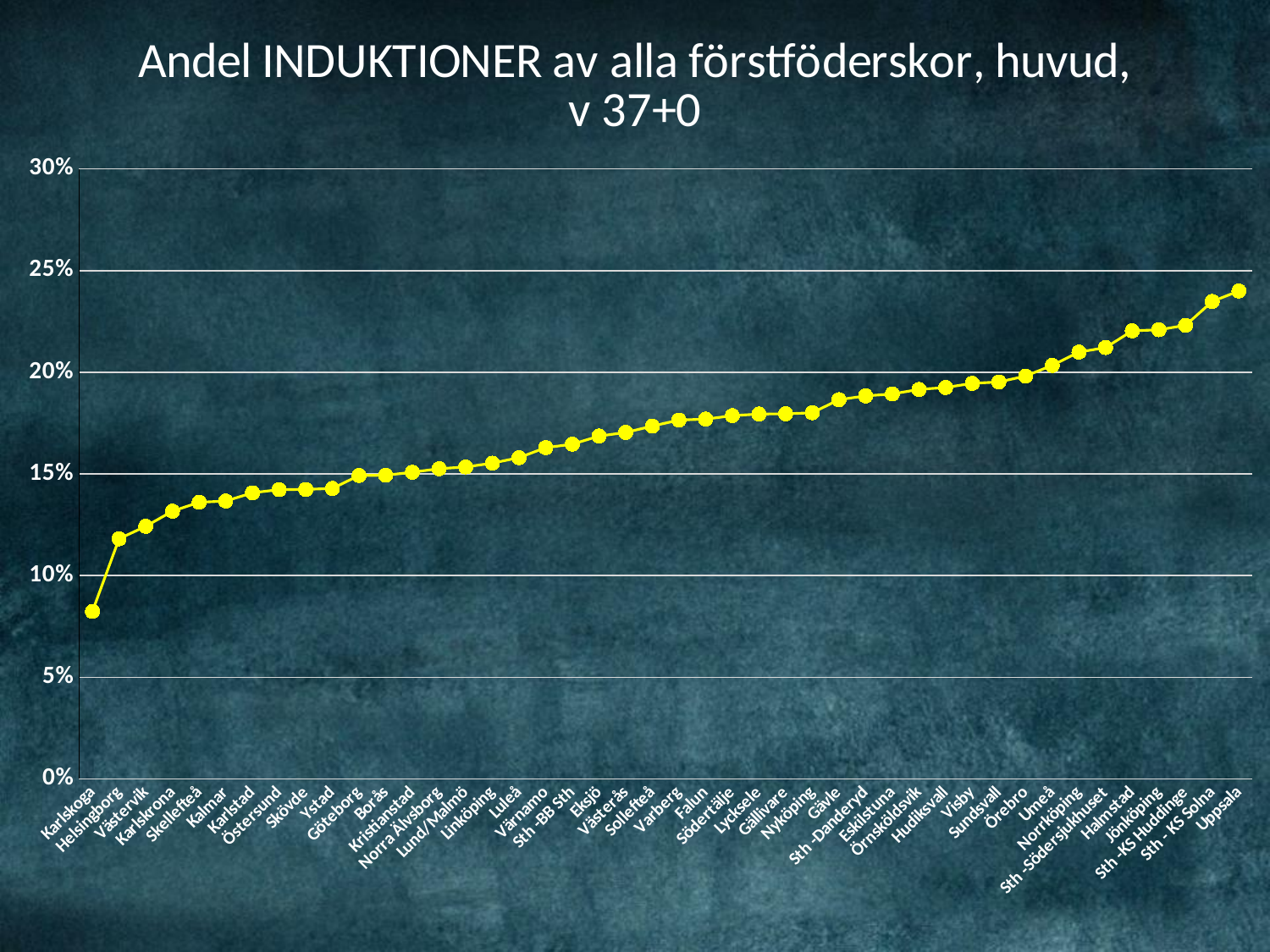
Is the value for Sth - KS Solna greater or less than 25%? less Is the value for Gävle greater or less than 15%? greater Which hospital has the highest share of inductions? Uppsala What is the highest value shown on the vertical axis? 30% Is the value for Karlskoga greater or less than 10%? less Do the values rise or fall from left to right along the x axis? rise What kind of chart is shown on the slide? line chart Which has a higher share of inductions, Borås or Halmstad? Halmstad Which hospital has the lowest share of inductions? Karlskoga How many hospitals are plotted on the chart? 44